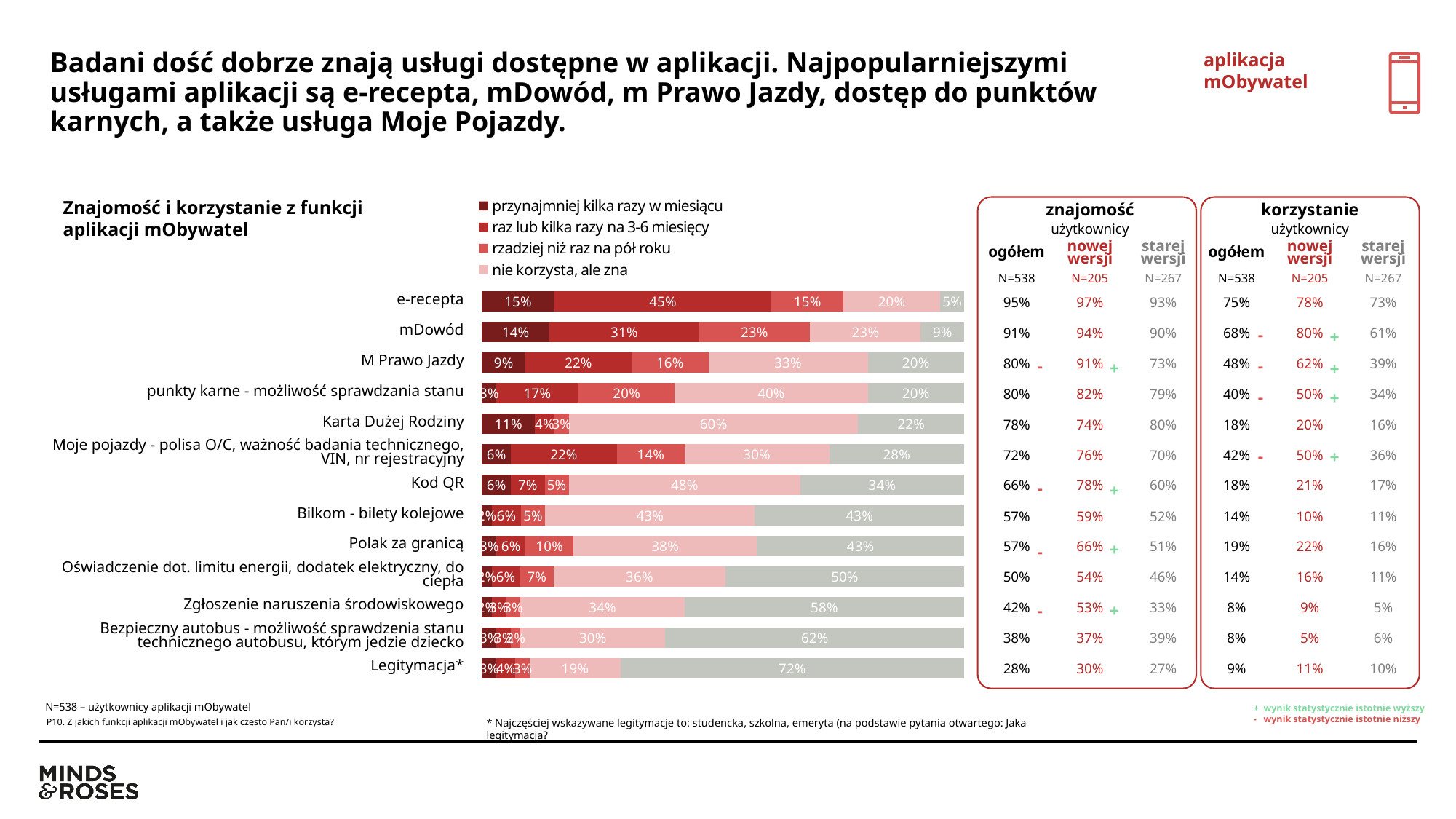
What is the value of 'przynajmniej kilka razy w miesiącu' for mDowód? 14% How many series does the chart legend list? 4 What is the value of 'raz lub kilka razy na 3-6 miesięcy' for e-recepta? 45% How many categories (functions) are plotted in the chart? 13 What is the difference between the 'raz lub kilka razy na 3-6 miesięcy' values for e-recepta and mDowód? 14% What is the value of 'rzadziej niż raz na pół roku' for Moje pojazdy - polisa O/C, ważność badania technicznego, VIN, nr rejestracyjny? 14% What kind of chart is used to show 'Znajomość i korzystanie z funkcji aplikacji mObywatel'? stacked bar chart What is the value of 'nie korzysta, ale zna' for Karta Dużej Rodziny? 60% Which is larger: the 'nie korzysta, ale zna' value for Kod QR or for Polak za granicą? Kod QR Which category has the highest value for 'nie korzysta, ale zna'? Karta Dużej Rodziny Which category has the highest value for 'przynajmniej kilka razy w miesiącu'? e-recepta What is the first entry listed in the chart legend? przynajmniej kilka razy w miesiącu